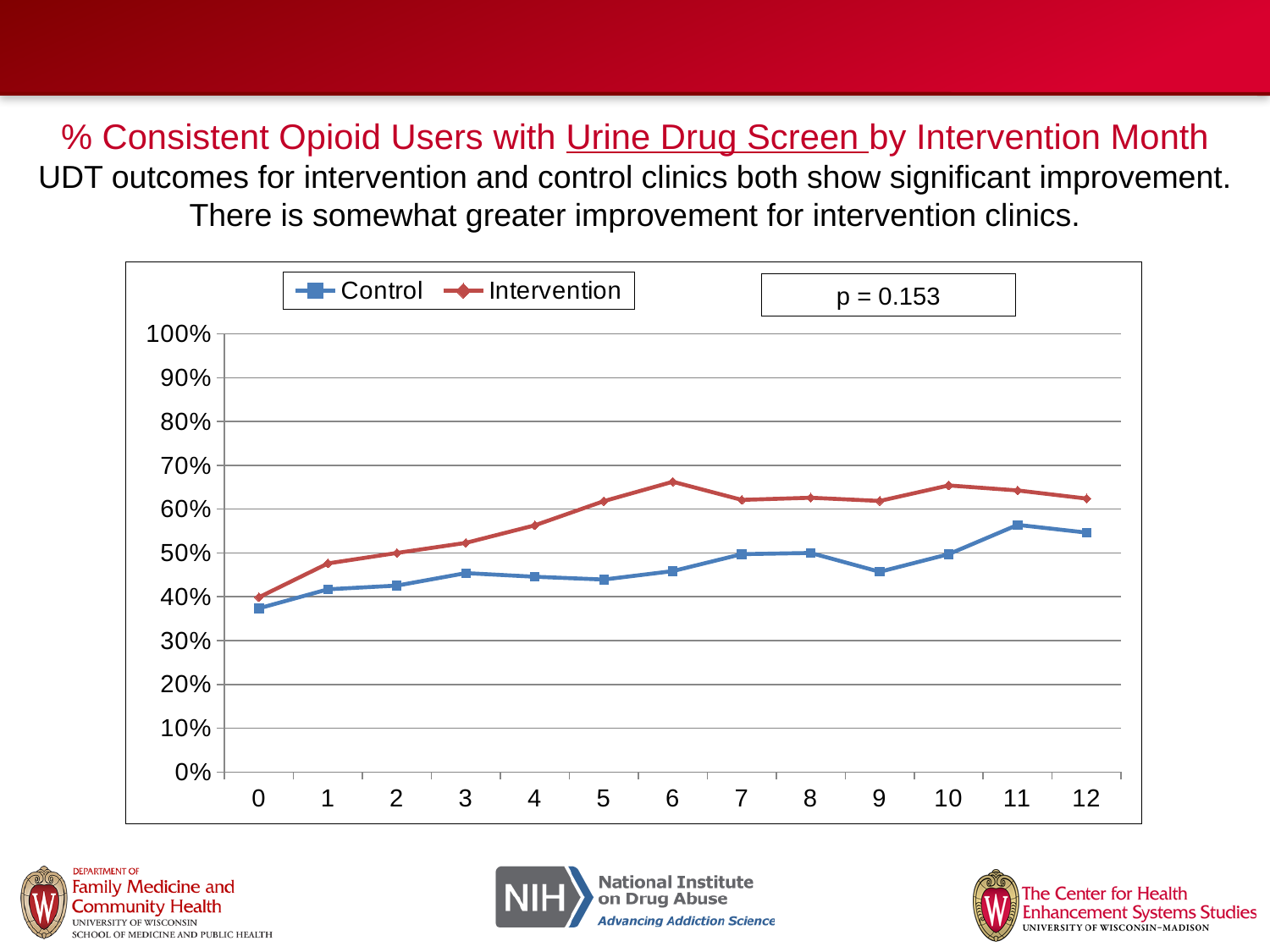
Which series is lower at month 0, Control or Intervention? Control Is the Intervention value at month 4 greater or less than 50%? greater Is the Control value at month 0 greater or less than 40%? less Is the Control value at month 11 greater or less than 50%? greater At which month is the Control series at its lowest value? 0 How many series does the legend list? 2 At month 6, which series has the higher value, Control or Intervention? Intervention Does the Intervention series rise or fall from month 0 to month 6? rise How many intervention months are plotted along the x axis? 13 What kind of chart is shown on the slide? line chart What p value is shown in the box on the chart? p = 0.153